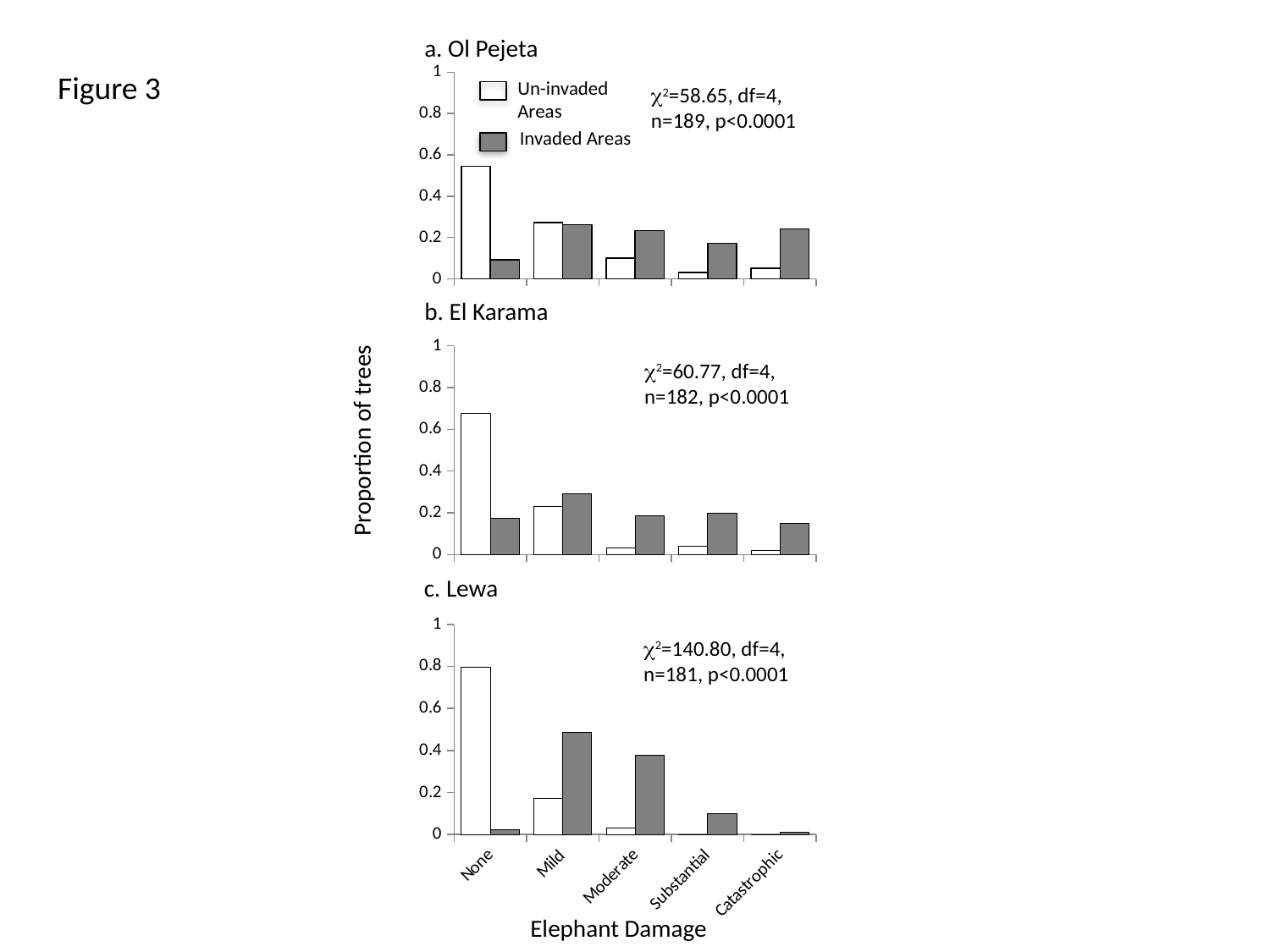
What kind of chart is the 'a. Ol Pejeta' chart? bar chart In the 'c. Lewa' chart, which damage category has the highest Invaded Areas bar? Mild In the 'a. Ol Pejeta' chart, is the Un-invaded Areas value for None greater or less than 0.4? greater In the 'a. Ol Pejeta' chart, for the Catastrophic category, which series has the larger value: Un-invaded Areas or Invaded Areas? Invaded Areas How many series does the legend on the 'a. Ol Pejeta' chart list? 2 In the 'c. Lewa' chart, which damage category has the lowest Invaded Areas bar? Catastrophic In the 'b. El Karama' chart, which damage category has the highest Un-invaded Areas bar? None In the 'b. El Karama' chart, is the Invaded Areas value for None greater or less than 0.4? less In the 'c. Lewa' chart, is the Un-invaded Areas value for None greater or less than 0.6? greater How many elephant damage categories are shown along the x axis of the 'c. Lewa' chart? 5 In the 'b. El Karama' chart, for the Mild category, which series has the larger value: Un-invaded Areas or Invaded Areas? Invaded Areas What is the label of the shared y axis for the three charts? Proportion of trees